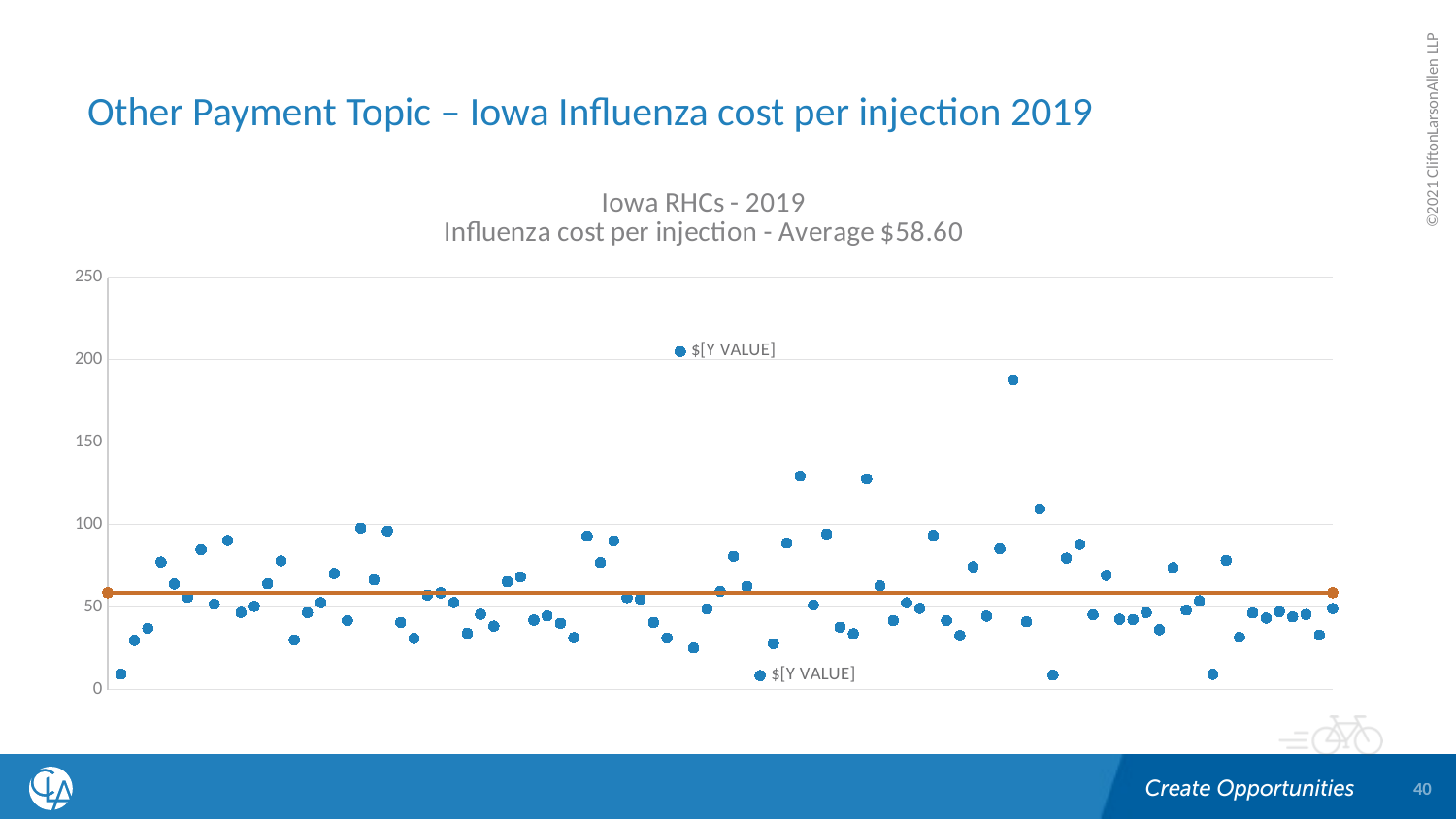
Is the horizontal average line greater or less than 50 on the y axis? greater What does the horizontal orange line across the chart represent? the average ($58.60) Is the lowest plotted point greater or less than 50? less Are most of the plotted points above or below 100? below What kind of chart is shown on the slide? scatter chart What is the highest value shown on the y axis? 250 What is the title of the chart? Iowa RHCs - 2019 Influenza cost per injection - Average $58.60 What average influenza cost per injection is stated in the chart title? $58.60